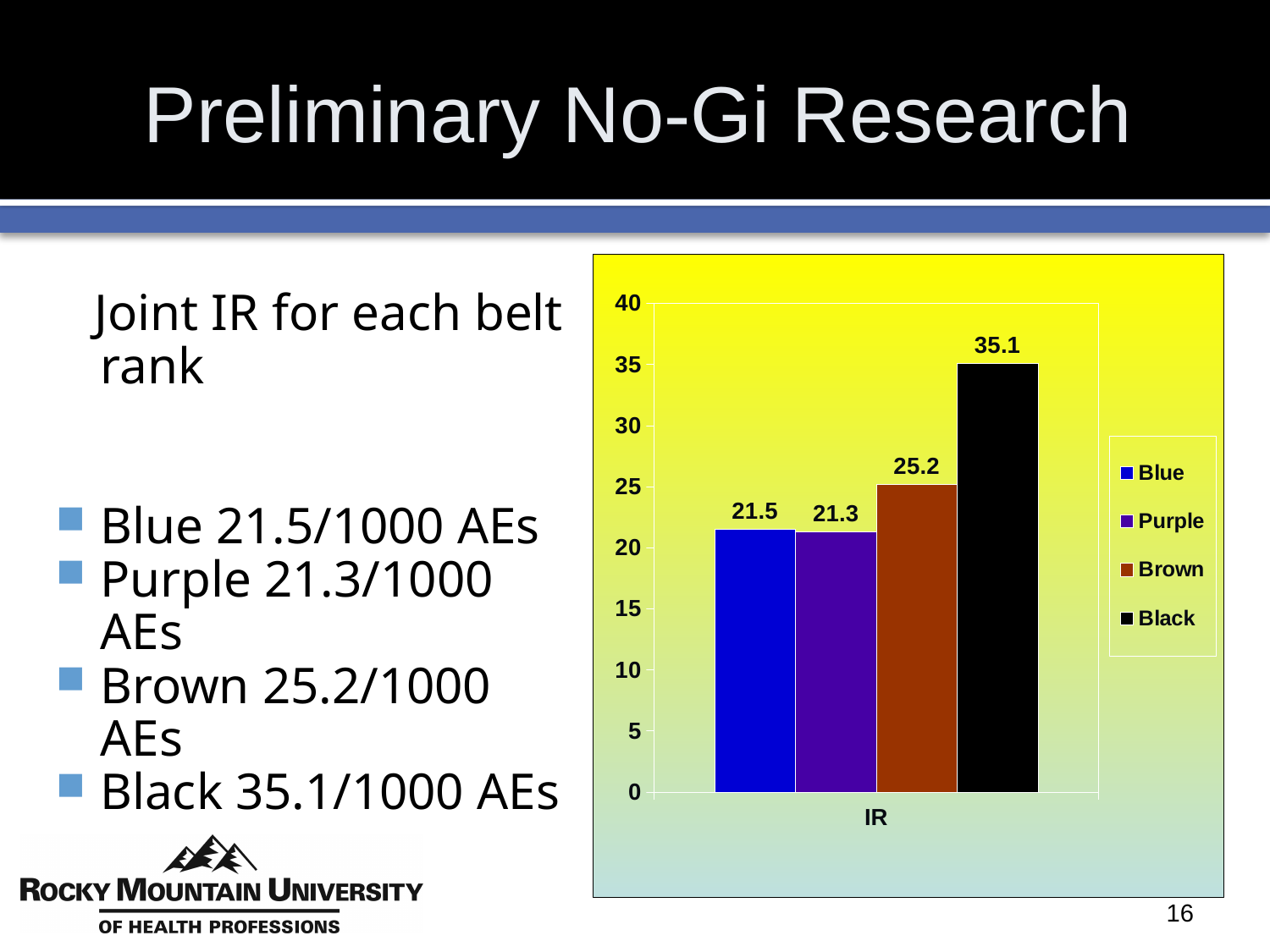
What is the IR value for the Brown belt rank? 25.2 What is the IR value for the Purple belt rank? 21.3 What is the difference between the IR values for Blue and Purple? 0.2 What is the IR value for the Black belt rank? 35.1 What kind of chart is shown on the slide? bar chart Which belt rank has the lowest IR value? Purple Which belt rank has the highest IR value? Black What is the difference between the IR values for Black and Brown? 9.9 What is the label on the x axis of the chart? IR How many series does the legend list? 4 Is the IR value for Black greater or less than 30? greater Which has a larger IR value, Brown or Blue? Brown